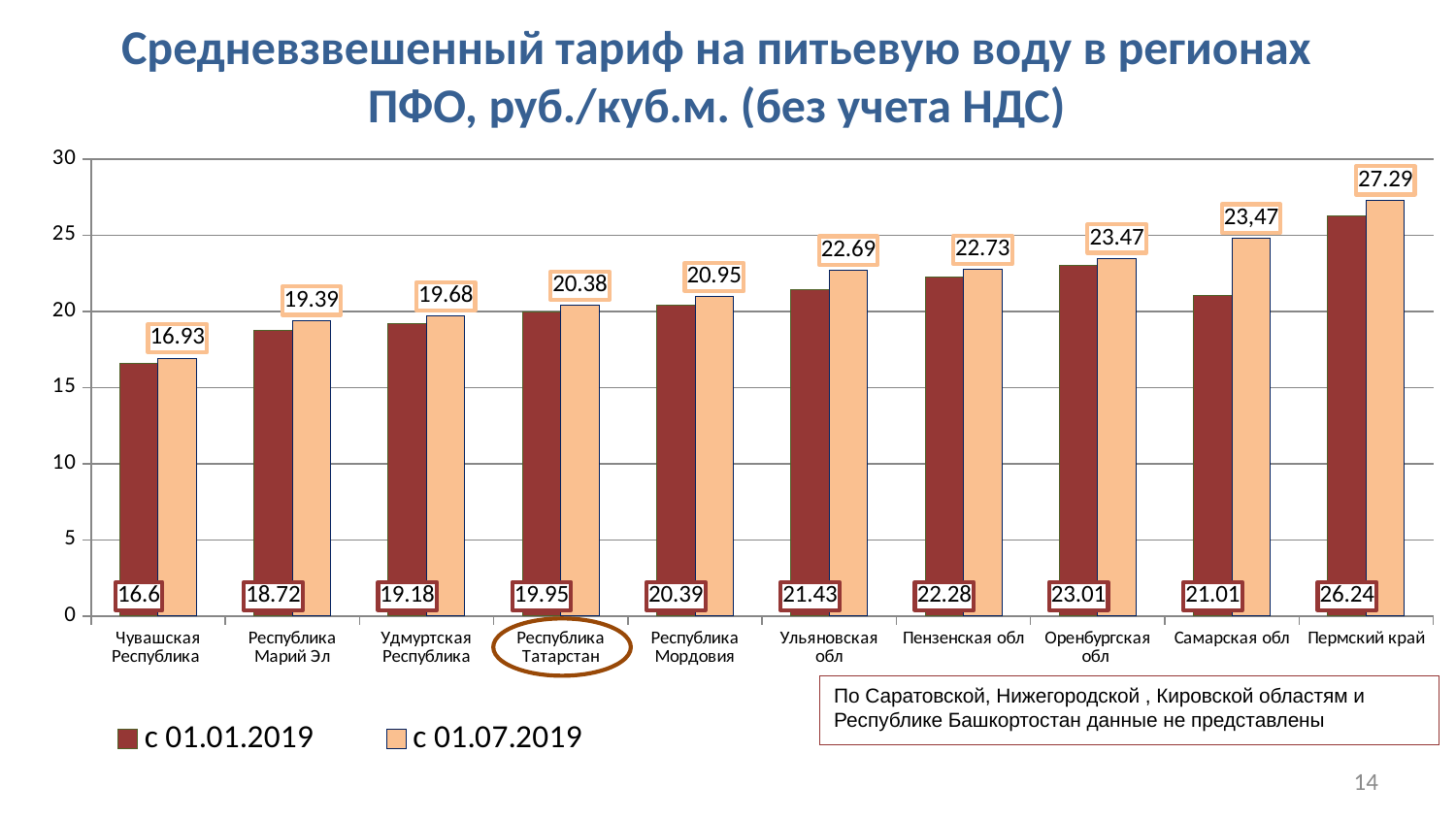
What is the value for Республика Татарстан in the series с 01.01.2019? 19.95 Which is larger for Самарская обл: the value for с 01.01.2019 or the value for с 01.07.2019? с 01.07.2019 What is the value for Самарская обл in the series с 01.07.2019? 23,47 What is the difference between the с 01.07.2019 and с 01.01.2019 values for Пермский край? 1.05 How many series does the legend list? 2 Is the value for Оренбургская обл in the series с 01.01.2019 greater or less than 20? greater Which region has the lowest value in the series с 01.01.2019? Чувашская Республика Which region on the x axis is circled on the slide? Республика Татарстан Which region has the highest value in the series с 01.07.2019? Пермский край How many regions are shown on the x axis of the chart? 10 What type of chart is shown on the slide? bar chart What is the value for Ульяновская обл in the series с 01.07.2019? 22.69